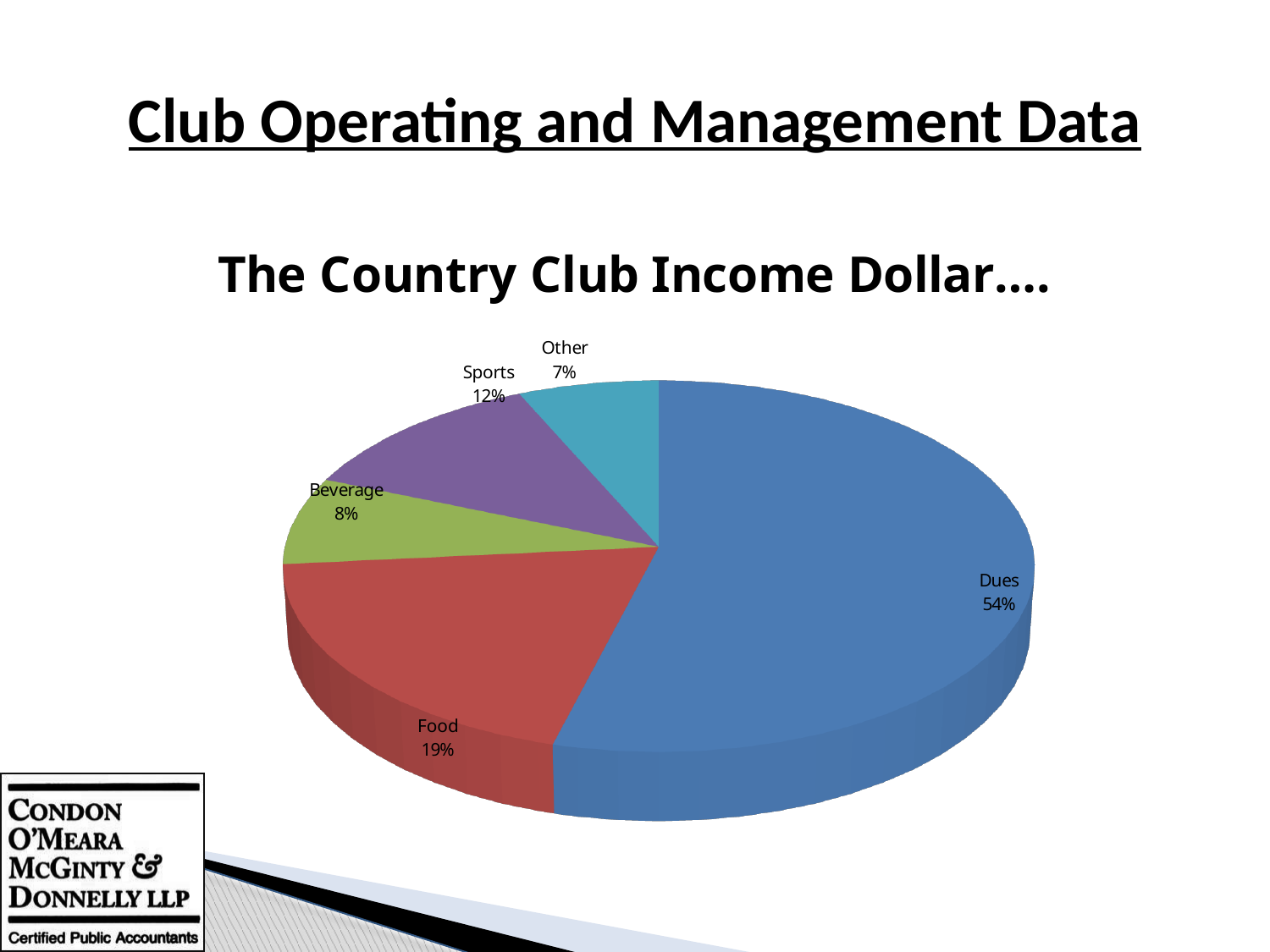
How many percentage points larger is the Dues share than the Food share? 35 Which is larger, the Sports share or the Beverage share? Sports Which category makes up the smallest share of the income dollar? Other Which category makes up the largest share of the income dollar? Dues What is the title of the chart? The Country Club Income Dollar.... How many categories are shown in the pie chart? 5 What percentage of the income dollar is Sports? 12% What type of chart is shown on the slide? Pie chart What share of the country club income dollar comes from Dues? 54% What percentage of the income dollar is Beverage? 8% What percentage of the income dollar is Other? 7% What percentage of the income dollar is Food? 19%